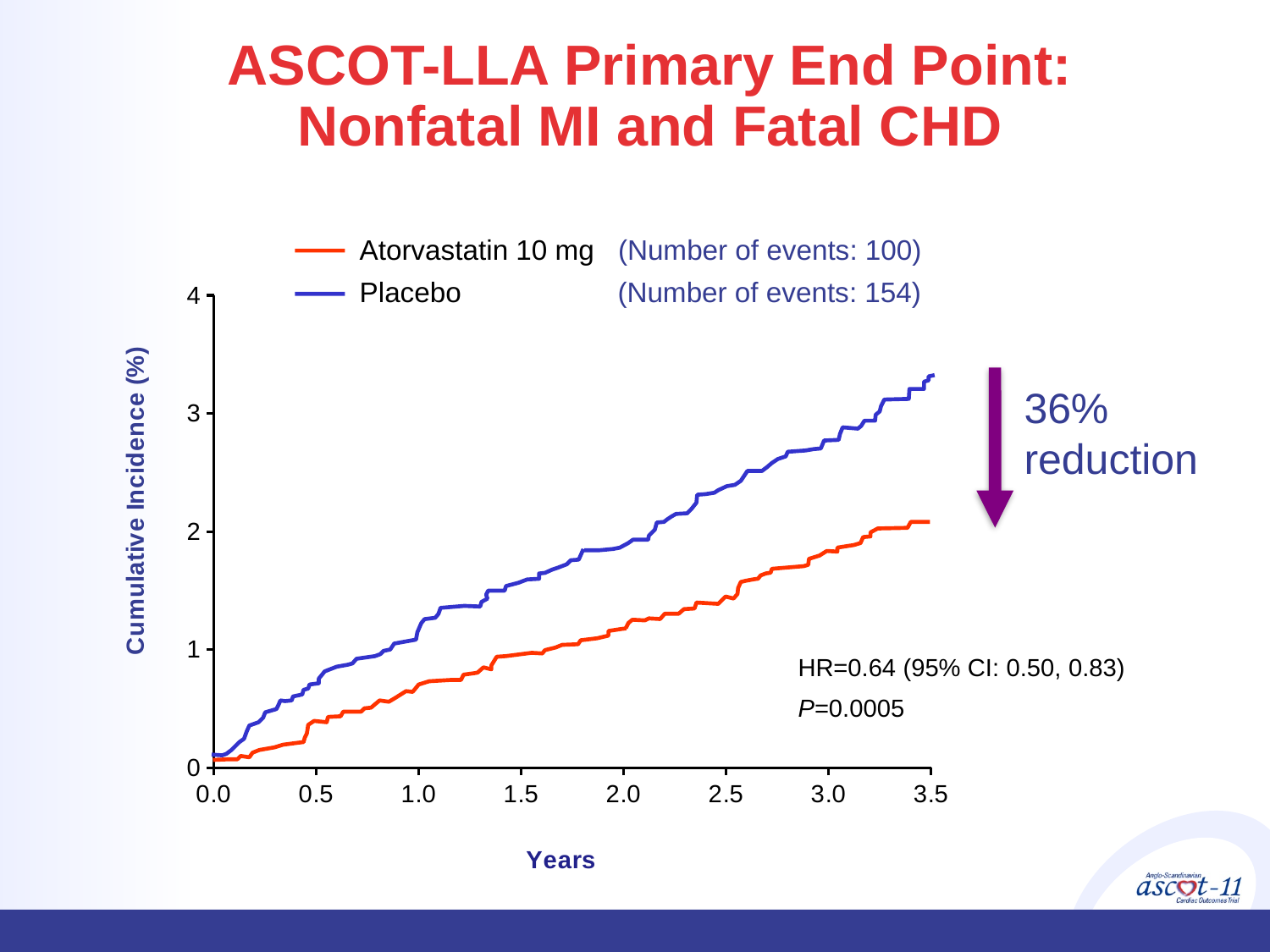
Which series has the higher cumulative incidence at 3.5 years, Atorvastatin 10 mg or Placebo? Placebo What kind of chart is shown on the slide? line chart How many more events occurred in the Placebo group than in the Atorvastatin 10 mg group? 54 What is the number of events for the Atorvastatin 10 mg group? 100 Is the cumulative incidence for Atorvastatin 10 mg at 1.0 years greater or less than 1? less Do the cumulative incidence curves rise or fall as years increase? rise What percentage reduction is shown next to the arrow on the chart? 36% reduction What is the number of events for the Placebo group? 154 How many series does the legend list? 2 Is the cumulative incidence for Atorvastatin 10 mg at 3.5 years greater or less than 2? greater Is the cumulative incidence for Placebo at 3.5 years greater or less than 3? greater What hazard ratio is printed on the chart? HR=0.64 (95% CI: 0.50, 0.83)